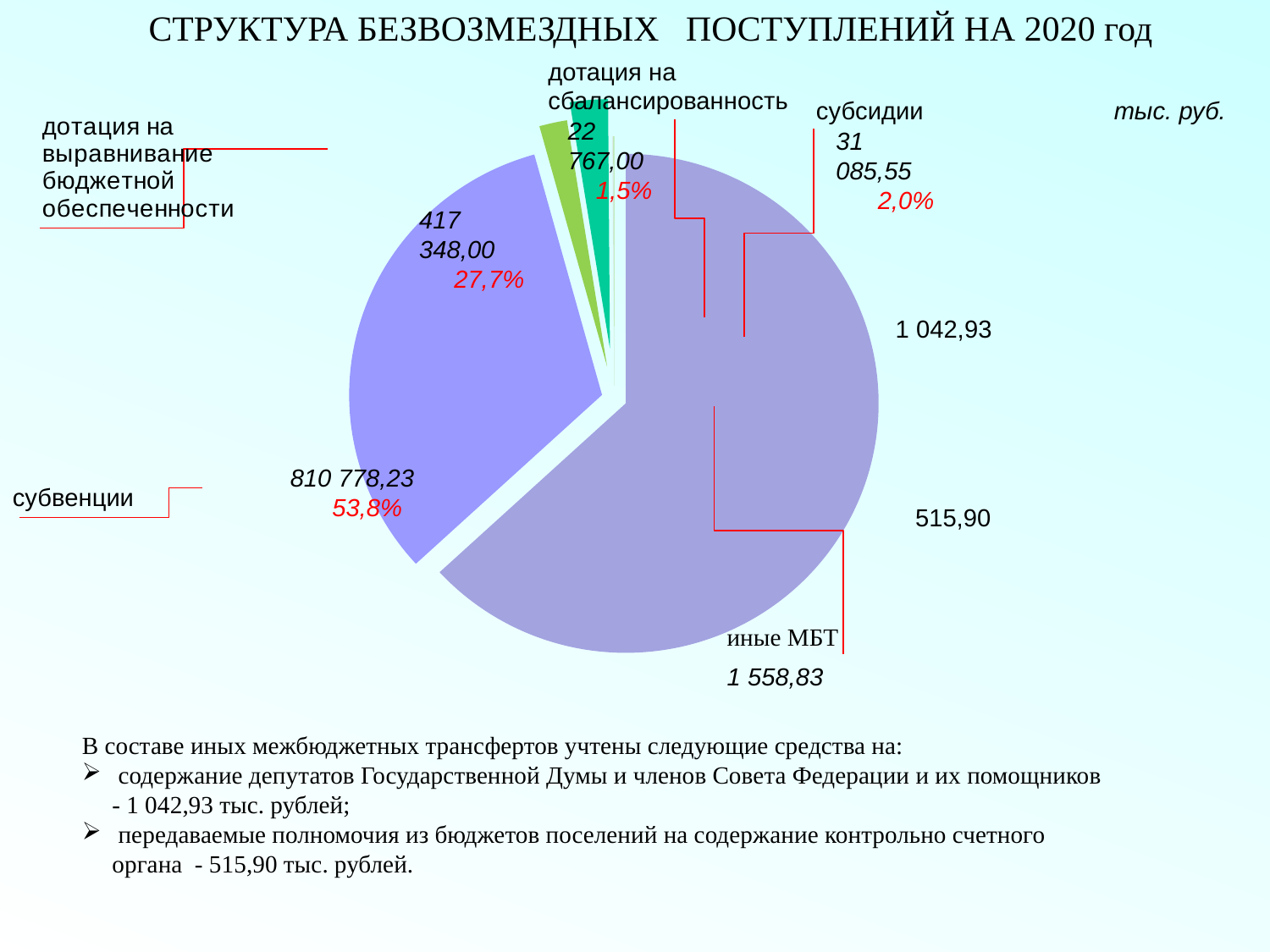
What kind of chart is shown on the slide? Pie chart What is the value shown for дотация на сбалансированность? 22 767,00 What share of the pie do субсидии account for? 2,0% Which category has the smallest value in the pie chart? иные МБТ Which is larger: субсидии or дотация на сбалансированность? субсидии What is the value shown for иные МБТ? 1 558,83 Which category has the largest share of the pie? субвенции In what units are the values on the chart given? тыс. руб. What is the difference between the values for субсидии and дотация на сбалансированность? 8 318,55 What share of the pie does дотация на сбалансированность account for? 1,5% How many categories (slices) does the pie chart have? 5 What is the value shown for субсидии? 31 085,55